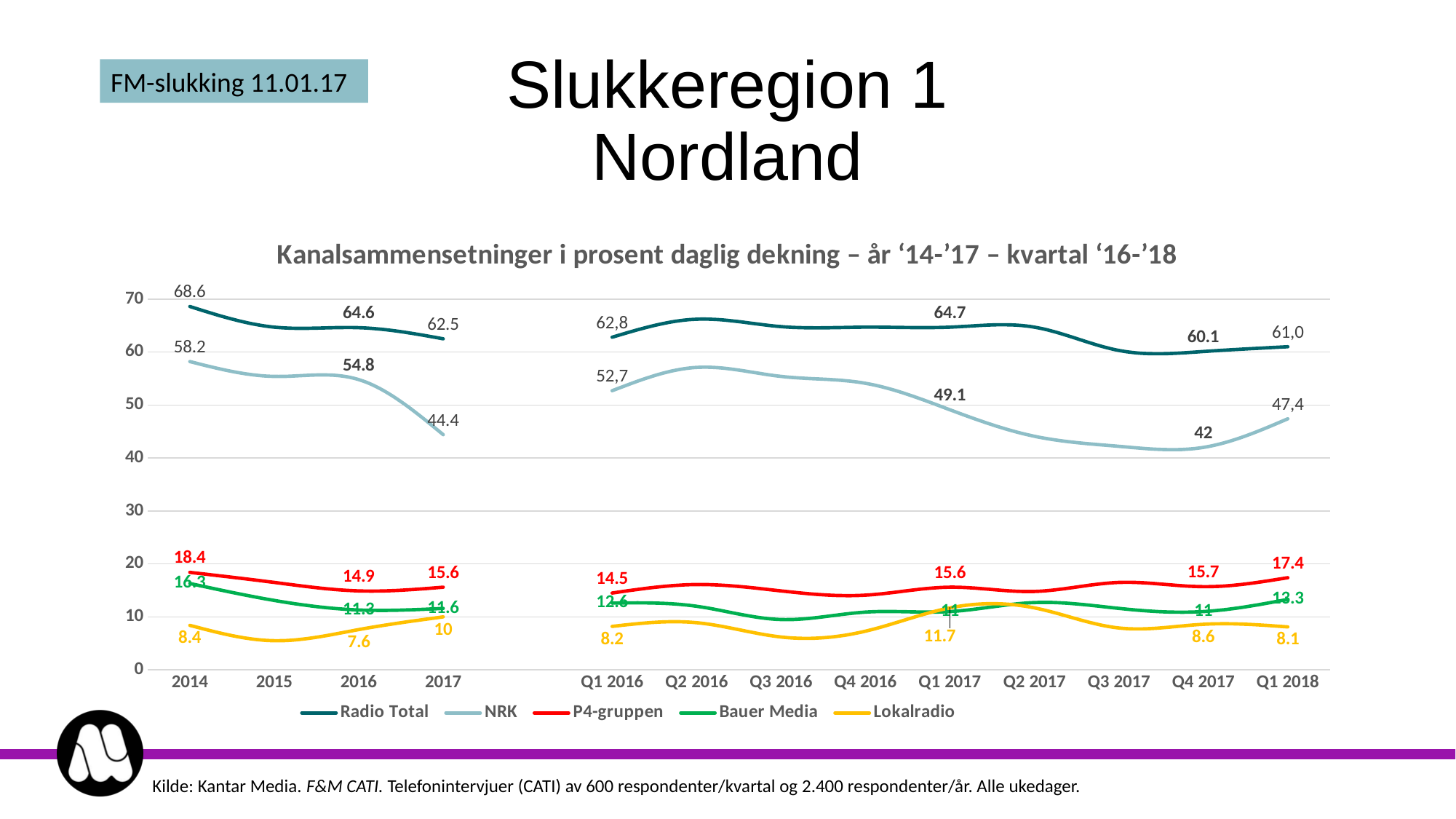
What is the value for NRK in 2017? 44.4 Is the value for NRK in Q3 2016 greater or less than 50? greater What is the value for Radio Total in 2014? 68.6 What is the value for Bauer Media in Q1 2016? 12.6 Does the NRK line rise or fall from 2014 to 2017? fall How many series does the legend list? 5 What is the difference between the Radio Total values in 2014 and 2017? 6.1 What type of chart is shown on the slide? line chart What is the value for Lokalradio in Q1 2017? 11.7 Which is larger: the NRK value in Q4 2017 or in Q1 2018? Q1 2018 What is the value for P4-gruppen in Q1 2018? 17.4 How many categories are shown on the x axis? 13